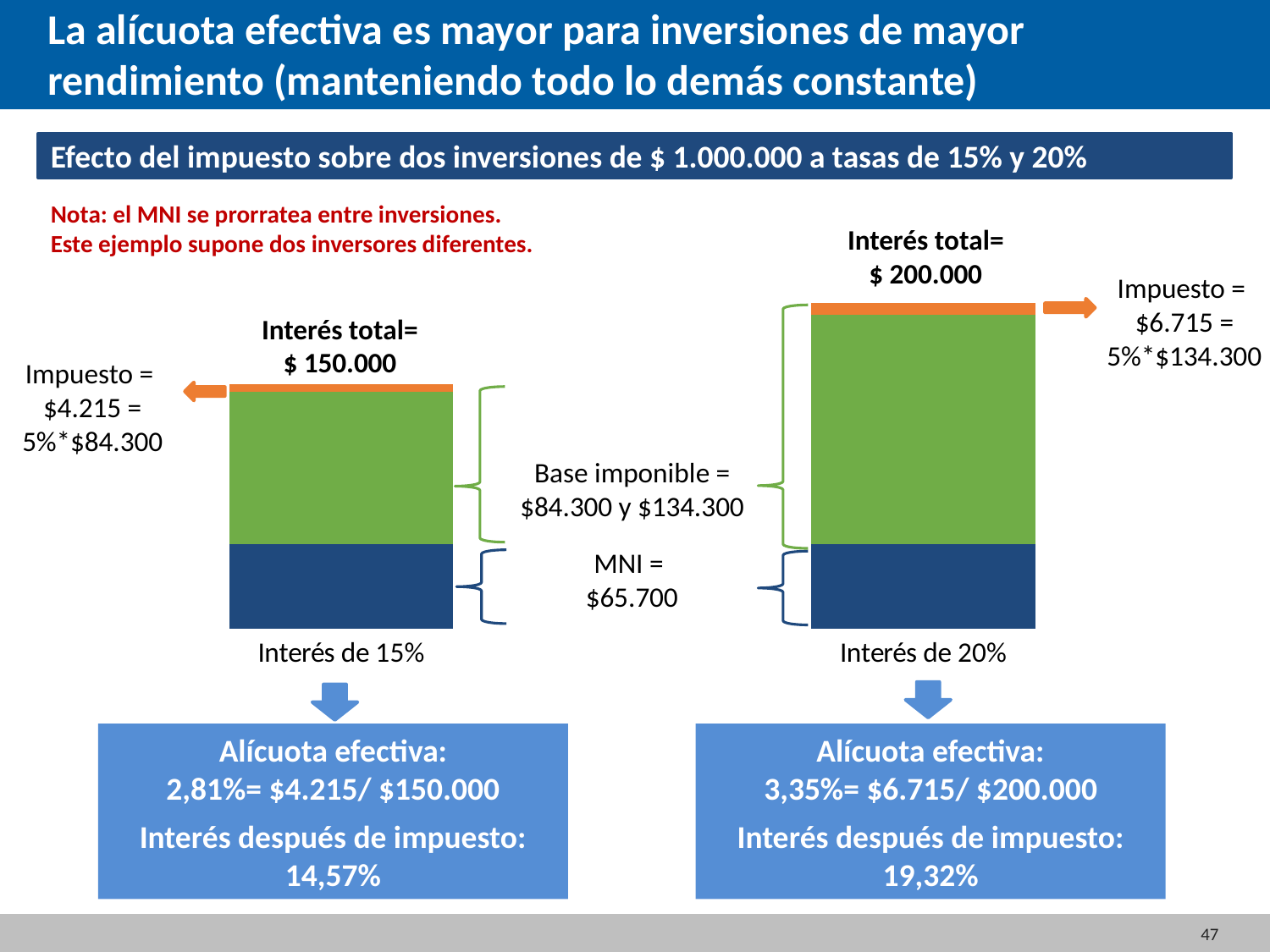
What is the MNI value shown for the dark blue segment of the bars? $65.700 What is the tax (Impuesto) amount shown for the 'Interés de 20%' bar? $6.715 What colour is the segment representing the tax (Impuesto) at the top of each bar? Orange What is the difference in tax (Impuesto) between the 'Interés de 20%' bar and the 'Interés de 15%' bar? $2.500 Which of the two bars is taller, 'Interés de 15%' or 'Interés de 20%'? Interés de 20% What is the taxable base (Base imponible) for the 'Interés de 20%' bar? $134.300 What is the tax (Impuesto) amount shown for the 'Interés de 15%' bar? $4.215 What is the total interest (Interés total) shown for the bar labelled 'Interés de 15%'? $ 150.000 What kind of chart is shown on the slide? Stacked bar chart What is the difference in total interest between the 'Interés de 20%' bar and the 'Interés de 15%' bar? $ 50.000 What is the total interest (Interés total) shown for the bar labelled 'Interés de 20%'? $ 200.000 How many bars are shown on the slide? 2